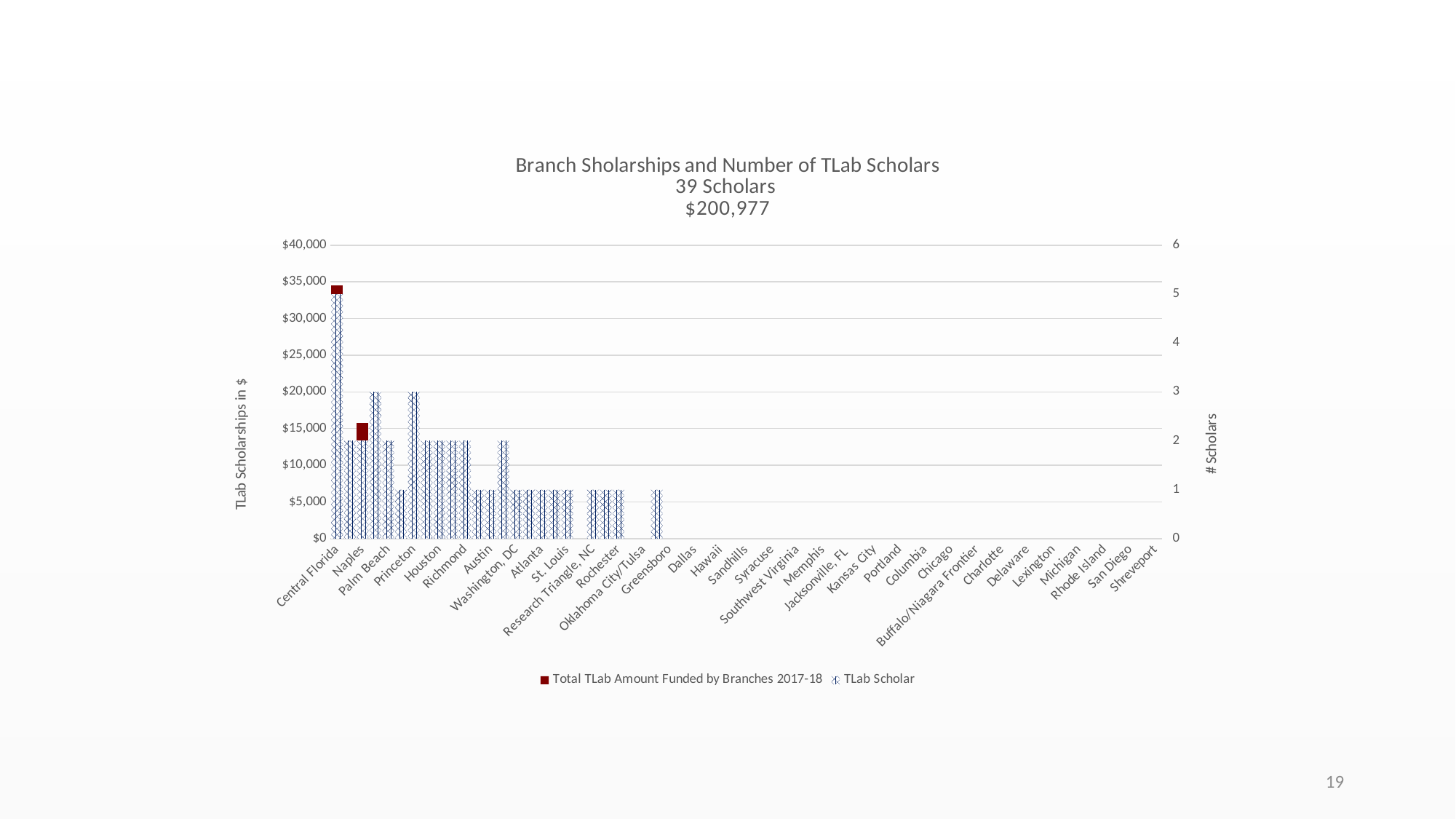
Do the TLab Scholar bars generally rise or fall moving from left to right along the x axis? fall Is the Total TLab Amount Funded by Branches 2017-18 for Central Florida greater or less than $30,000? greater Is the Total TLab Amount Funded by Branches 2017-18 for Naples greater or less than $20,000? less What type of chart is shown on the slide? Bar chart Which branch has the highest TLab Scholar bar? Central Florida How many TLab Scholars does the Central Florida bar show on the right axis? 5 What total dollar amount is stated in the chart title? $200,977 What is the title of the left vertical axis? TLab Scholarships in $ Which has the taller TLab Scholar bar, Central Florida or Naples? Central Florida How many series does the legend list? 2